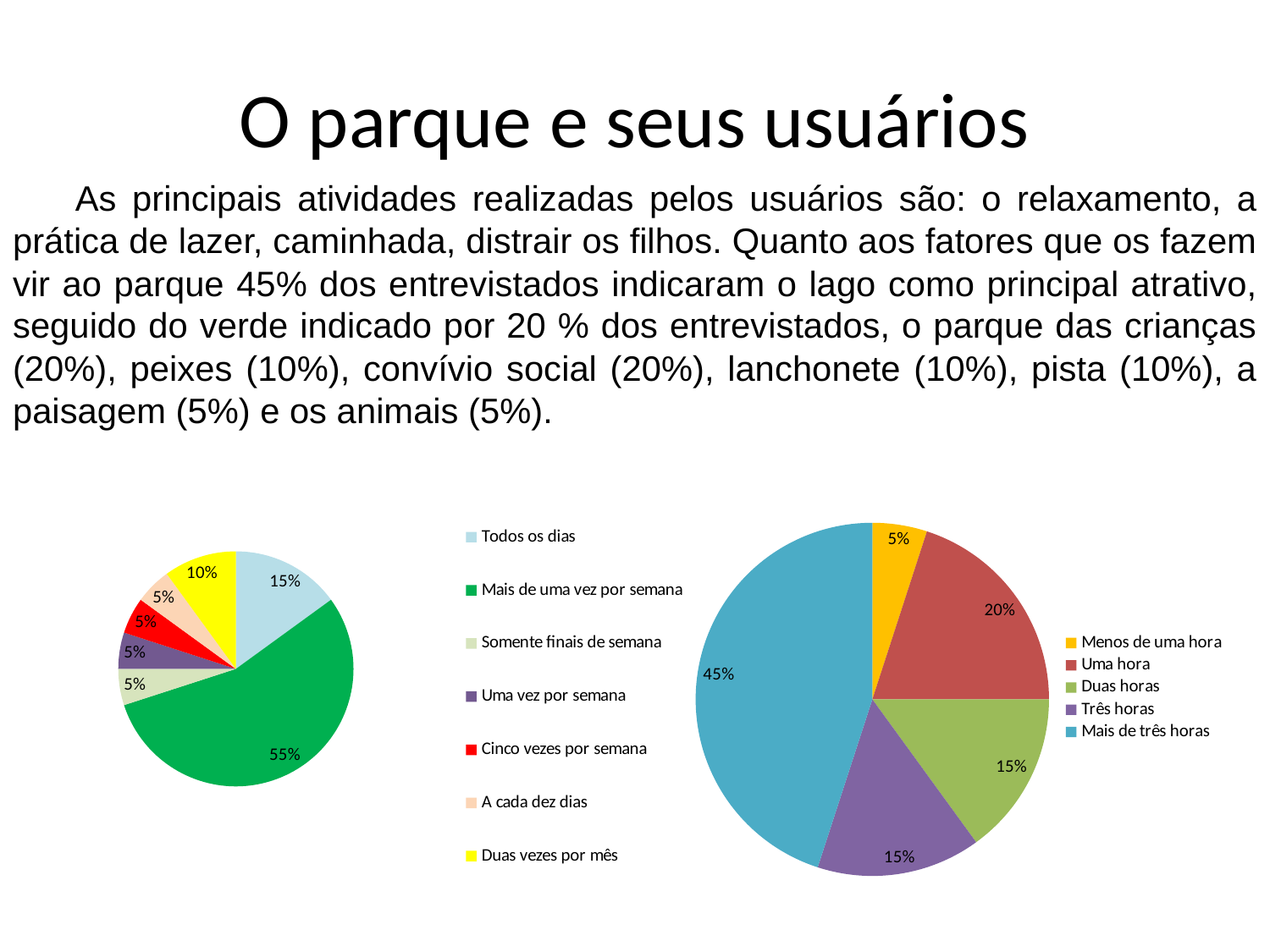
How many categories does the legend of the right pie chart list? 5 In the right pie chart, what share is shown for "Uma hora"? 20% How many categories does the legend of the left pie chart list? 7 In the right pie chart, which is larger: the share for "Uma hora" or the share for "Duas horas"? Uma hora In the left pie chart, what share is shown for "Mais de uma vez por semana"? 55% In the left pie chart, what is the difference between the shares for "Mais de uma vez por semana" and "Todos os dias"? 40% In the left pie chart, what share is shown for "Duas vezes por mês"? 10% What type of chart is the chart on the left of the slide? pie chart In the right pie chart, which category has the smallest slice? Menos de uma hora In the left pie chart, which category has the largest slice? Mais de uma vez por semana